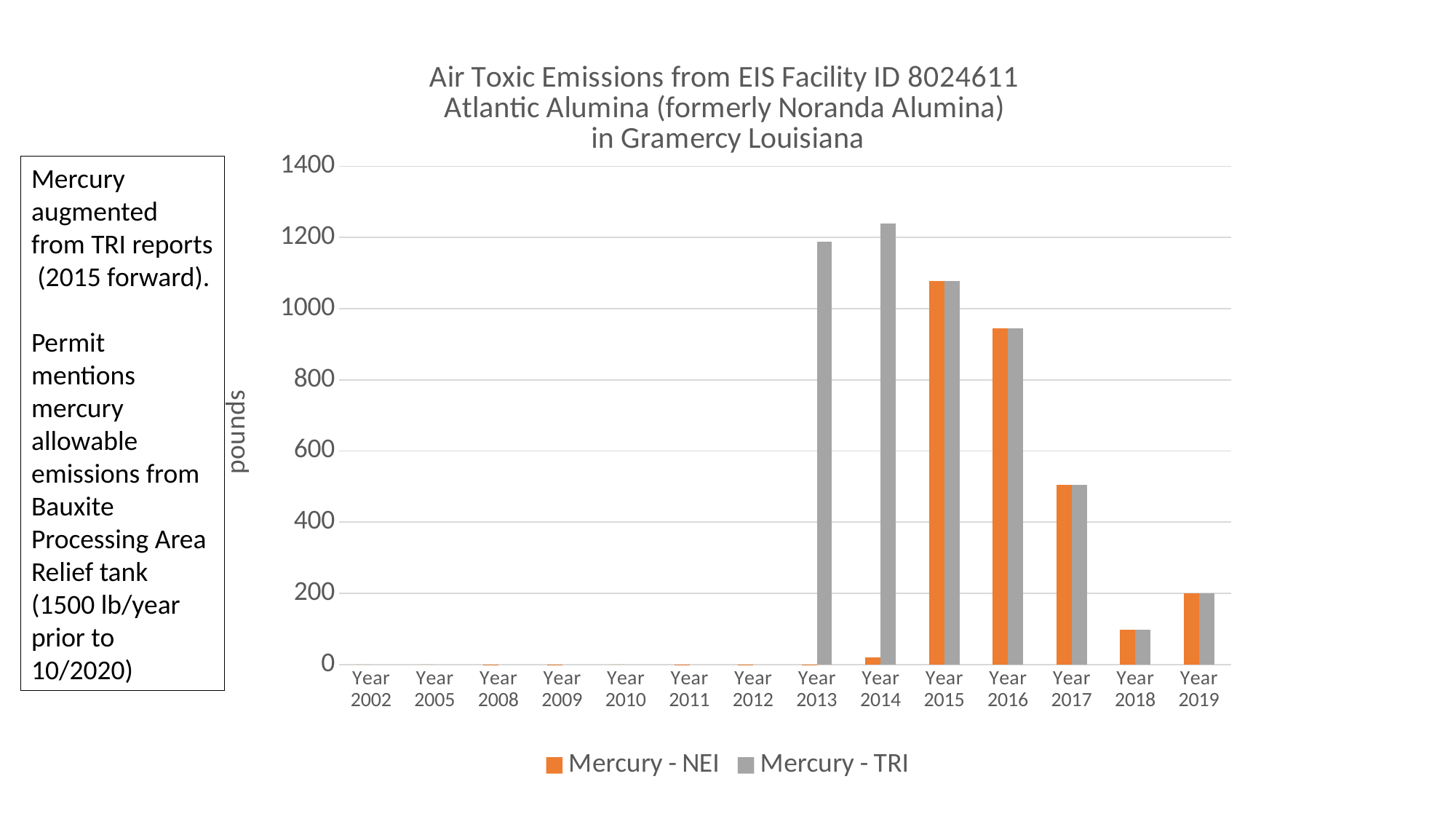
In which year is the Mercury - TRI value highest? Year 2014 What kind of chart is shown on the slide? bar chart How many year categories are shown on the x axis? 14 Which is larger in Year 2014: the Mercury - NEI value or the Mercury - TRI value? Mercury - TRI Is the Mercury - NEI value for Year 2017 greater or less than 400? greater Is the Mercury - TRI value for Year 2013 greater or less than 1000? greater Is the Mercury - NEI value for Year 2018 greater or less than 200? less Do the Mercury - NEI values rise or fall from Year 2015 to Year 2018? fall In which year is the Mercury - NEI value highest? Year 2015 How many series does the legend list? 2 What is the label on the vertical axis? pounds